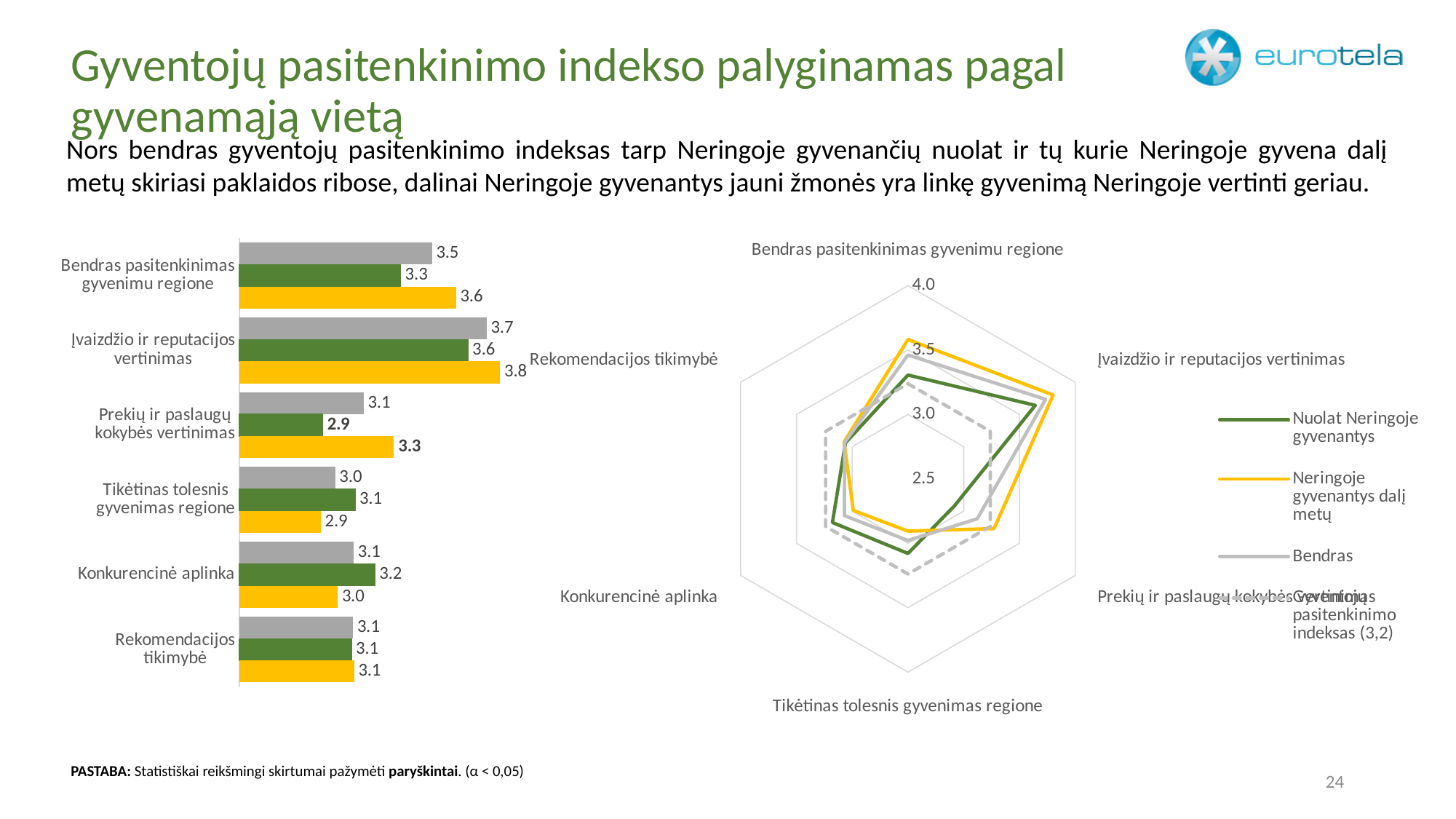
On the left bar chart, which category has the lowest green bar value? Prekių ir paslaugų kokybės vertinimas On the left bar chart, what is the yellow bar value (Neringoje gyvenantys dalį metų) for 'Bendras pasitenkinimas gyvenimu regione'? 3.6 On the left bar chart, what is the gray bar value (Bendras) for 'Įvaizdžio ir reputacijos vertinimas'? 3.7 On the left bar chart, for 'Tikėtinas tolesnis gyvenimas regione', which is larger: the green bar or the yellow bar? green bar (3.1) On the left bar chart, how many categories are shown? 6 On the left bar chart, which category has the highest yellow bar value? Įvaizdžio ir reputacijos vertinimas How many entries does the legend of the radar chart on the right list? 4 On the left bar chart, what is the difference between the yellow and green bar values for 'Prekių ir paslaugų kokybės vertinimas'? 0.4 On the left bar chart, what value do all three bars share for 'Rekomendacijos tikimybė'? 3.1 On the radar chart on the right, what is the highest axis tick value shown? 4.0 On the left bar chart, what is the green bar value (Nuolat Neringoje gyvenantys) for 'Prekių ir paslaugų kokybės vertinimas'? 2.9 What type of chart is on the left side of the slide? bar chart